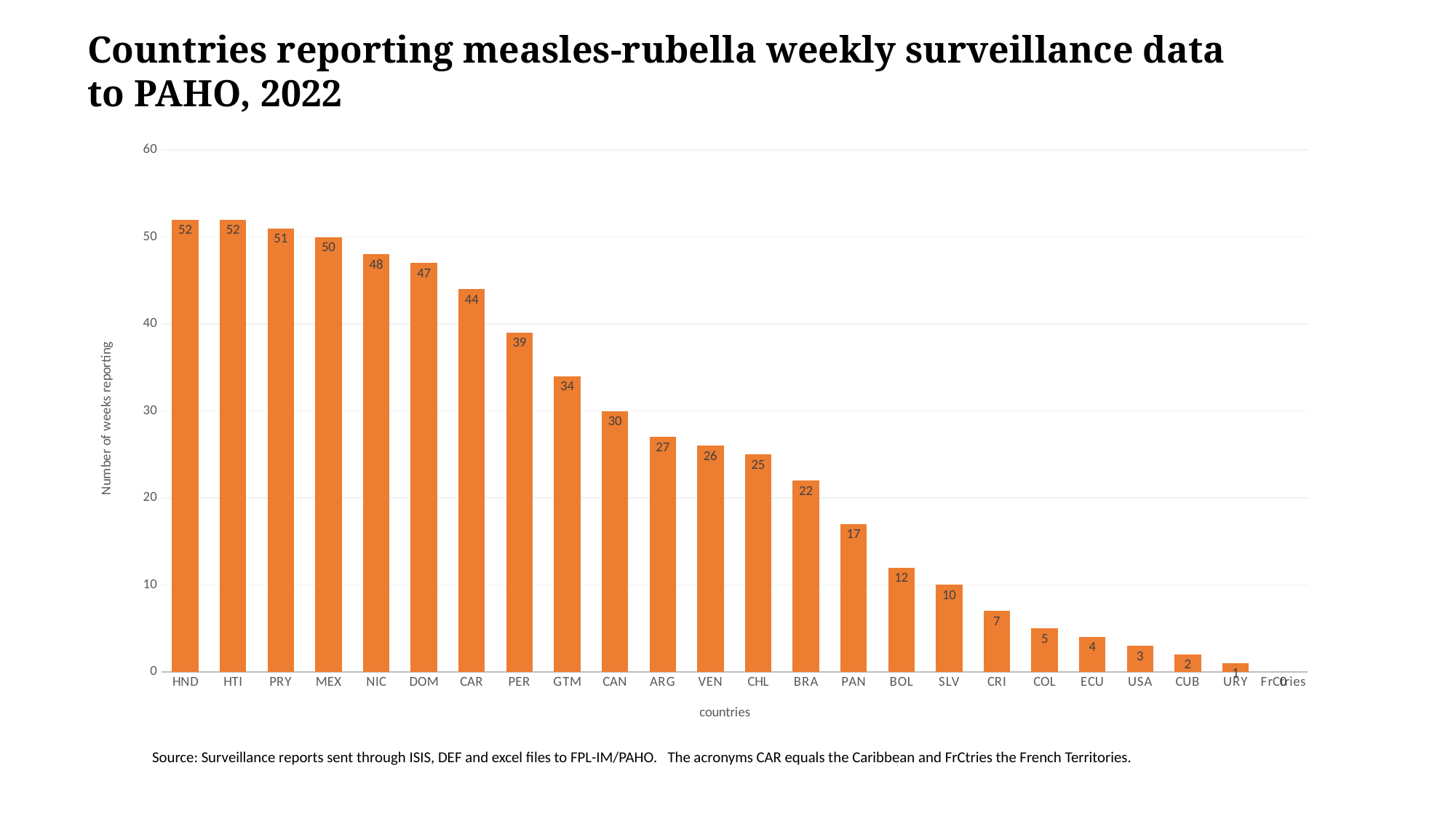
What is the value for PER? 39 What is the number of weeks reporting for BRA? 22 Which has a larger value, DOM or CAR? DOM Which has a larger value, BOL or CRI? BOL How many weeks of reporting does MEX show? 50 What is the difference between the values for NIC and CAN? 18 Do the values rise or fall moving from left to right along the x axis? fall How many countries or territories are shown on the x axis? 24 What is the label of the y axis? Number of weeks reporting What is the difference between the values for GTM and PAN? 17 What kind of chart is shown on the slide? bar chart What is the value for USA? 3